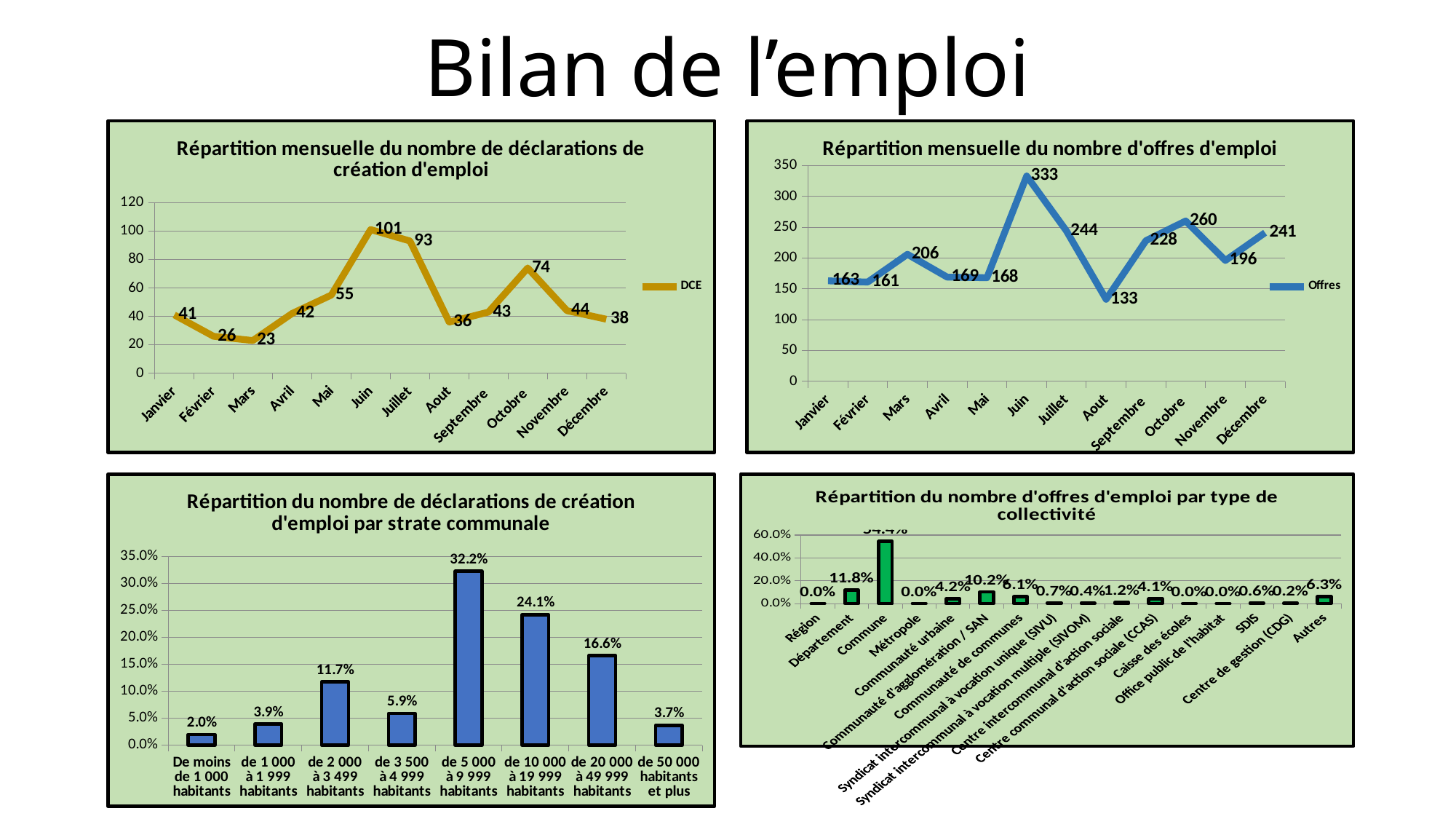
In the chart 'Répartition mensuelle du nombre d'offres d'emploi', which month has the highest value? Juin In the chart 'Répartition du nombre de déclarations de création d'emploi par strate communale', what is the value for 'de 5 000 à 9 999 habitants'? 32.2% In the chart 'Répartition du nombre de déclarations de création d'emploi par strate communale', which category has the lowest value? De moins de 1 000 habitants In the chart 'Répartition mensuelle du nombre d'offres d'emploi', how many months are plotted? 12 In the chart 'Répartition du nombre d'offres d'emploi par type de collectivité', what is the value for Département? 11.8% In the chart 'Répartition du nombre de déclarations de création d'emploi par strate communale', what is the difference between the values for 'de 10 000 à 19 999 habitants' and 'de 20 000 à 49 999 habitants'? 7.5% In the chart 'Répartition mensuelle du nombre de déclarations de création d'emploi', what is the value for Juin? 101 In the chart 'Répartition mensuelle du nombre d'offres d'emploi', which is larger, the value for Octobre or the value for Décembre? Octobre In the chart 'Répartition mensuelle du nombre de déclarations de création d'emploi', what is the difference between the values for Juin and Juillet? 8 What type of chart is 'Répartition mensuelle du nombre d'offres d'emploi'? Line chart In the chart 'Répartition mensuelle du nombre d'offres d'emploi', what is the value for Aout? 133 In the chart 'Répartition mensuelle du nombre de déclarations de création d'emploi', which month has the lowest value? Mars